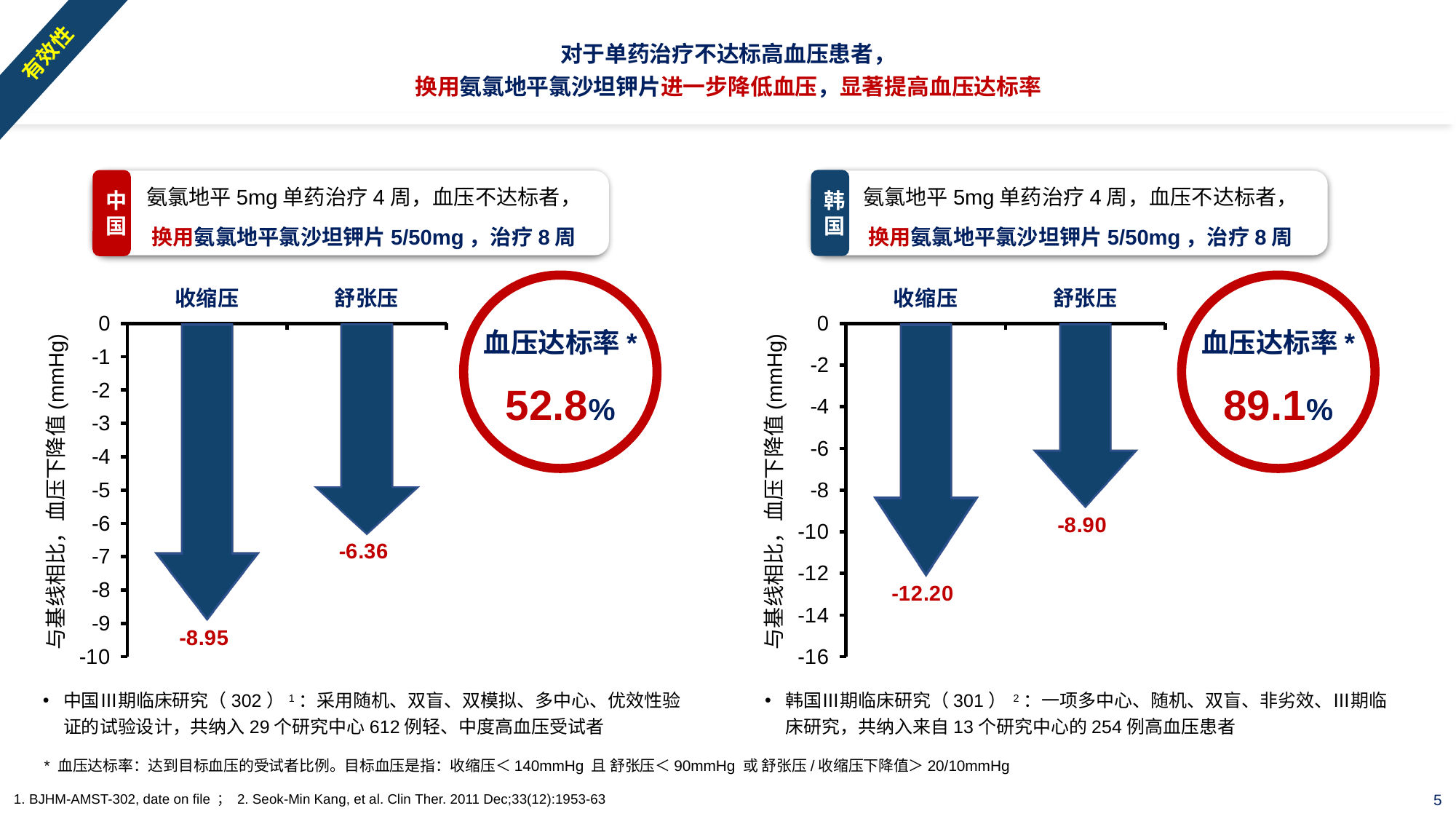
How many categories are plotted in the left (中国) chart? 2 In the left (中国) chart, which category has the lowest (most negative) value? 收缩压 In the right (韩国) chart, what is the difference between the 收缩压 and 舒张压 values? 3.30 In the right (韩国) chart, what is the value for 收缩压? -12.20 In the left (中国) chart, what is the value for 收缩压? -8.95 In the left (中国) chart, what is the value for 舒张压? -6.36 In the right (韩国) chart, what is the value for 舒张压? -8.90 What kind of chart is the right (韩国) chart? bar chart In the left (中国) chart, what is the difference between the 收缩压 and 舒张压 values? 2.59 In the right (韩国) chart, which category shows the larger blood pressure reduction, 收缩压 or 舒张压? 收缩压 What is the y-axis label of the left (中国) chart? 与基线相比，血压下降值 (mmHg) What is the lowest tick value shown on the y-axis of the right (韩国) chart? -16